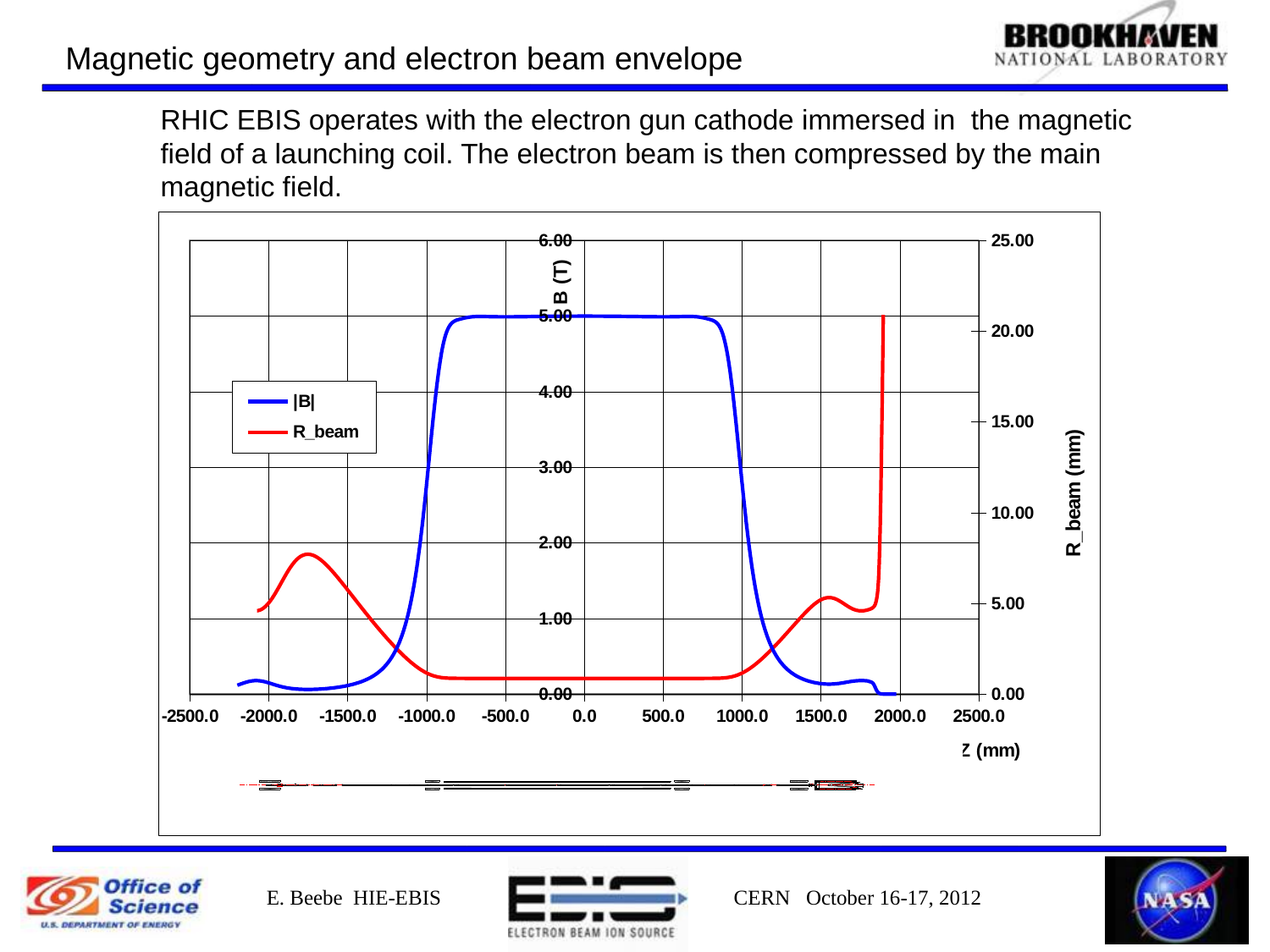
Is the value of |B| at Z = -2000.0 mm greater or less than 1.00 T? less Does |B| rise or fall as Z goes from -1000.0 mm to -500.0 mm? rise Is the value of |B| at Z = 0.0 mm greater or less than 4.00 T? greater What is the label of the right-hand vertical axis of the chart? R_beam (mm) Does |B| rise or fall as Z goes from 1000.0 mm to 1500.0 mm? fall How many series does the chart legend list? 2 What are the two series named in the chart legend? |B| and R_beam What kind of chart is shown on the slide? line chart Is the value of R_beam at Z = 0.0 mm greater or less than 5.00 mm? less Which is larger: |B| at Z = 0.0 mm or |B| at Z = -2000.0 mm? |B| at Z = 0.0 mm